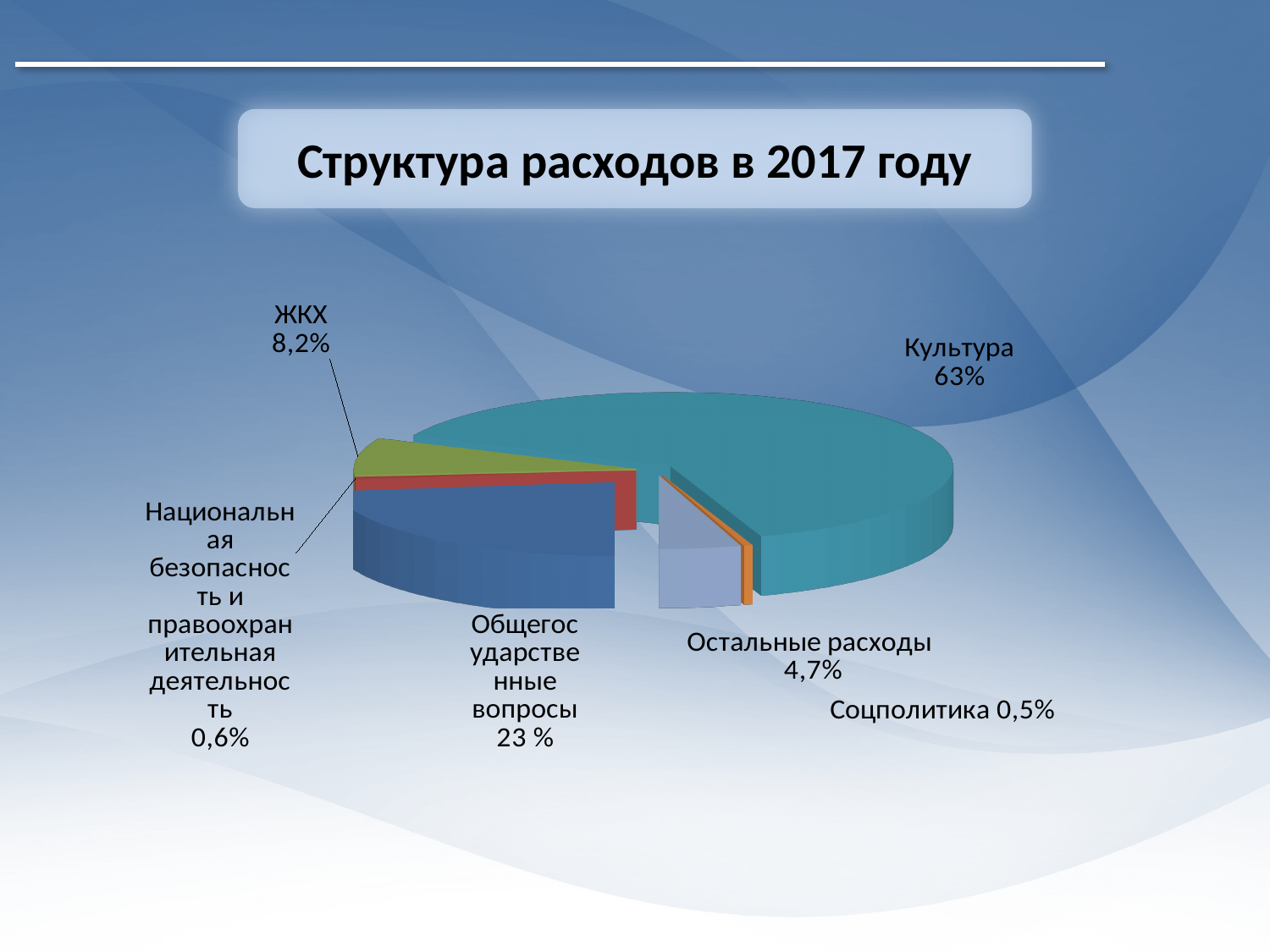
What is the value shown for ЖКХ? 8,2% What kind of chart is shown on the slide? pie chart Which category has the largest share of the pie? Культура Which is larger, the share for ЖКХ or the share for Остальные расходы? ЖКХ What share of expenditures does Культура account for? 63% What is the difference in percentage points between Культура and Общегосударственные вопросы? 40 What is the value shown for Соцполитика? 0,5% What is the value shown for Общегосударственные вопросы? 23 % Which category has the smallest share of the pie? Соцполитика What is the title of the chart on the slide? Структура расходов в 2017 году How many slices does the pie chart have? 6 What is the value shown for Остальные расходы? 4,7%